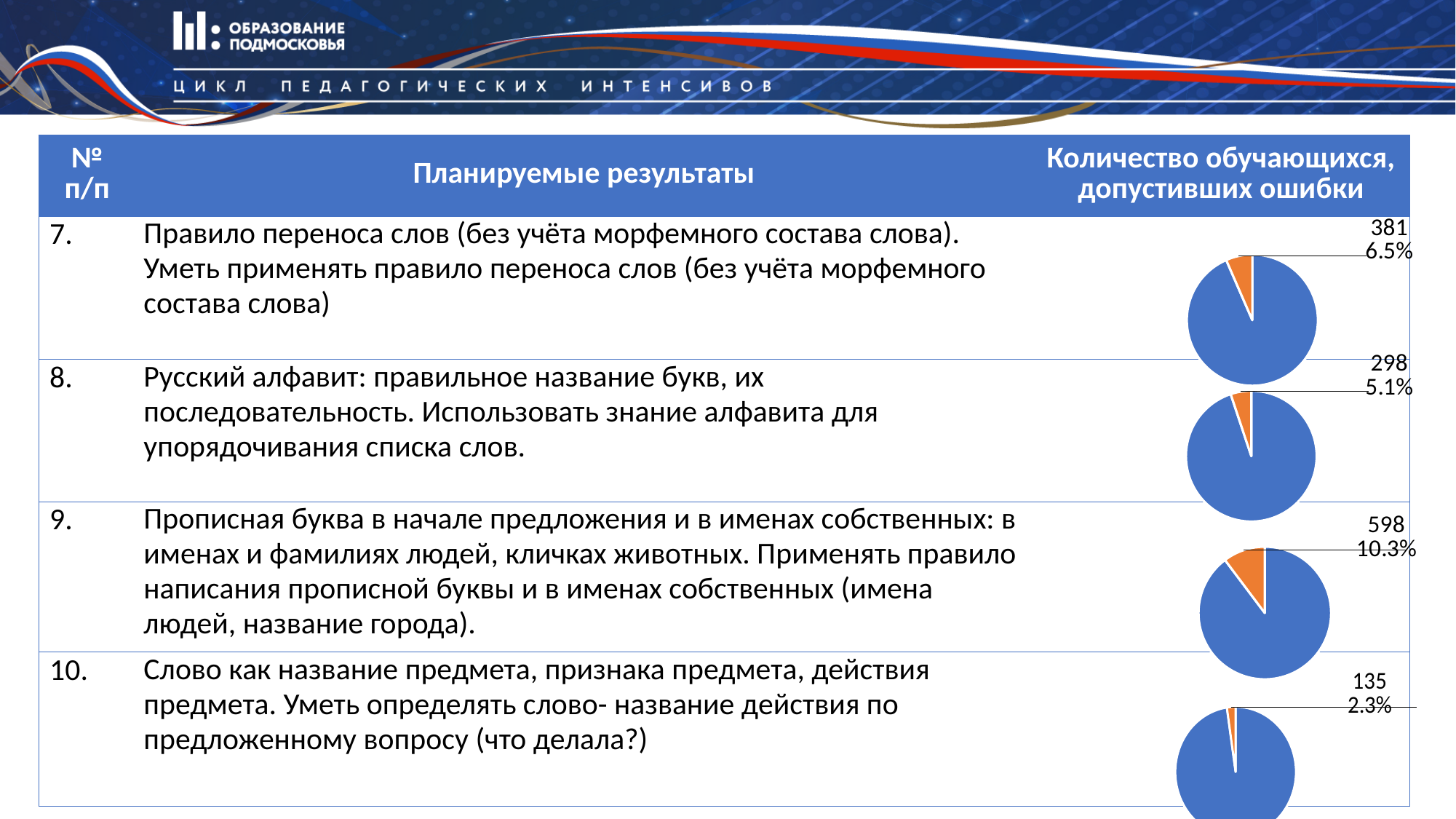
In the pie chart for row 9, what percentage is printed for the orange slice? 10.3% In the pie chart for row 10, what percentage is printed for the orange slice? 2.3% In the pie chart for row 8, what number is printed on the orange slice's data label? 298 What is the difference between the labelled values of the orange slices in the pie charts for row 9 and row 10? 463 In the pie chart for row 9, what number is printed on the orange slice's data label? 598 In the pie chart for row 10, what number is printed on the orange slice's data label? 135 Across the four pie charts on the slide, which row has the largest labelled orange slice? row 9 In the pie chart for row 8, what percentage is printed for the orange slice? 5.1% Across the four pie charts on the slide, which row has the smallest labelled orange slice? row 10 In the pie chart for row 7, what number is printed on the orange slice's data label? 381 What kind of chart is shown in row 7 of the table? pie chart